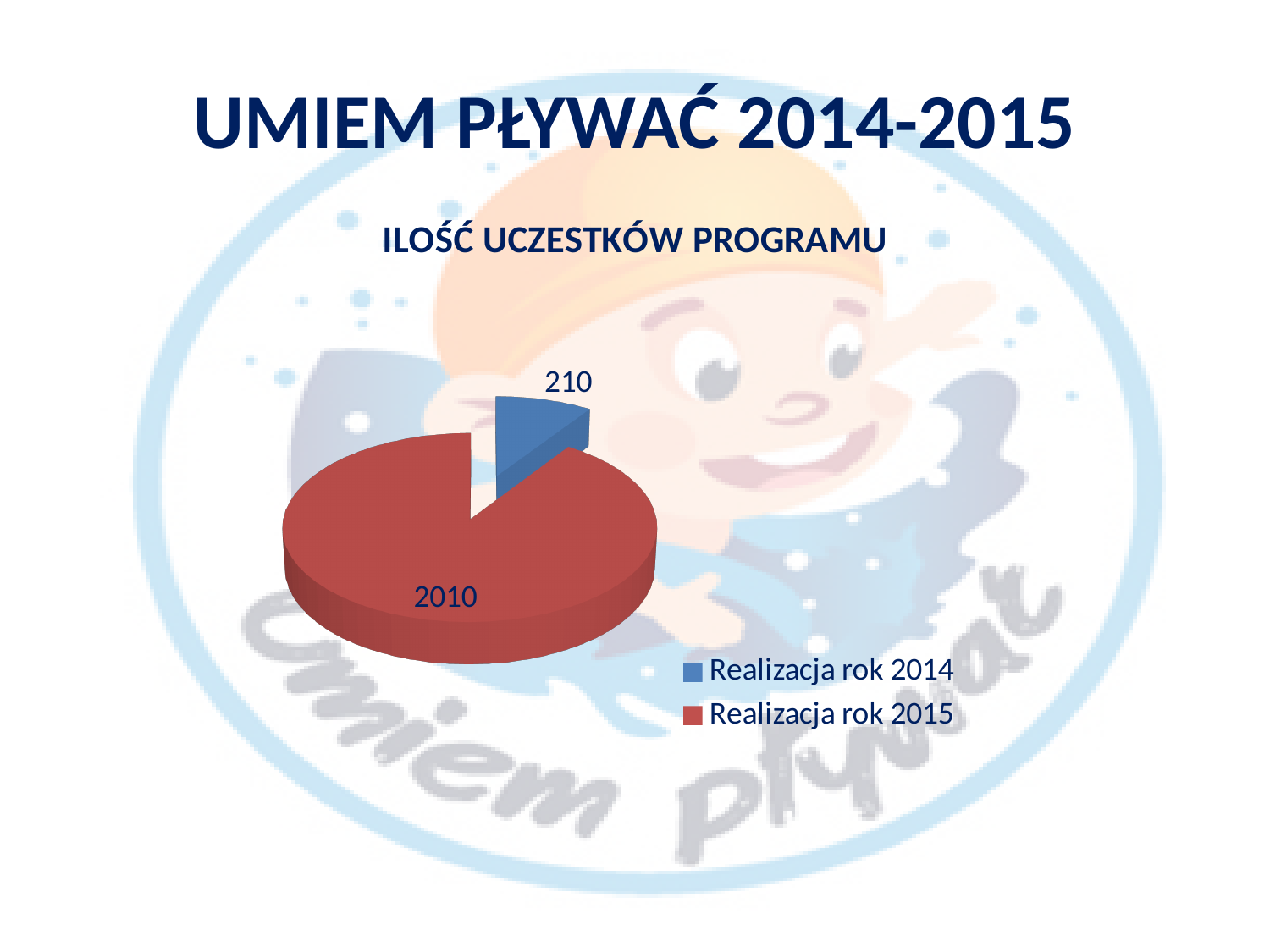
Which is larger, the value for Realizacja rok 2014 or Realizacja rok 2015? Realizacja rok 2015 What is the difference between the values for Realizacja rok 2015 and Realizacja rok 2014? 1800 Which slice is the smallest in the pie chart? Realizacja rok 2014 How many slices does the pie chart have? 2 What is the value for Realizacja rok 2015? 2010 How many entries does the legend list? 2 What kind of chart is shown on the slide? Pie chart Which slice is the largest in the pie chart? Realizacja rok 2015 What is the value for Realizacja rok 2014? 210 What is the title of the chart? ILOŚĆ UCZESTKÓW PROGRAMU What colour is the slice for Realizacja rok 2015? Red What is the total of the two values shown in the pie chart? 2220